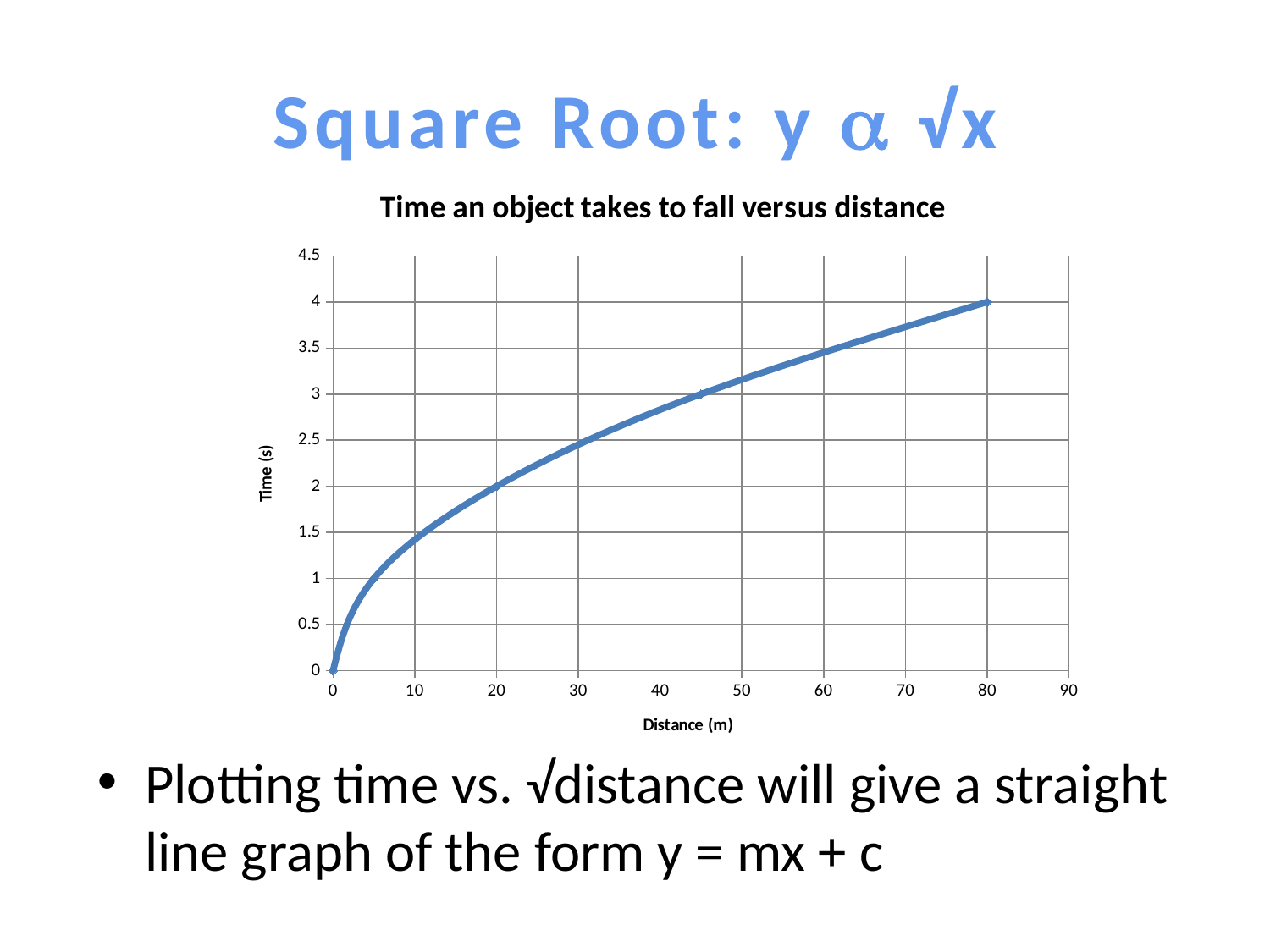
At which plotted distance is the time value highest? 80 What is the time value at a distance of 20 m? 2 Is the time value at a distance of 10 m greater or less than 1? greater What is the time value at a distance of 80 m? 4 What type of chart is shown on the slide? line chart Is the time value at a distance of 40 m greater or less than 3? less What is the title of the chart? Time an object takes to fall versus distance Does the time value rise or fall as distance increases along the x axis? rise What is the label of the vertical axis? Time (s) Is the time value at a distance of 60 m greater or less than 3? greater What is the time value at a distance of 0 m? 0 Which is larger, the time value at 20 m or the time value at 80 m? 80 m